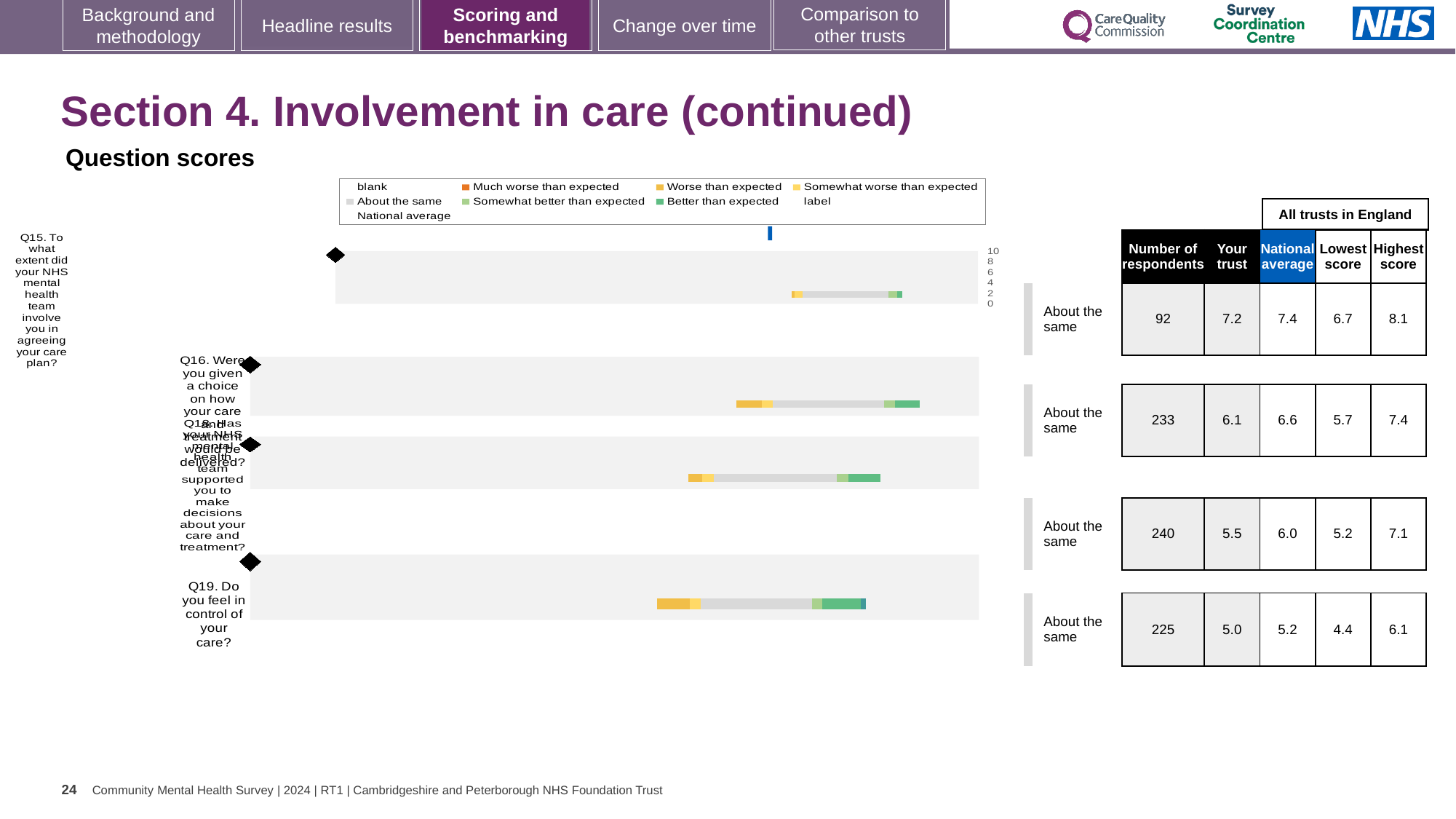
What is the 'Your trust' score for Q16 in the table? 6.1 For Q16, which is larger: the 'Your trust' score or the national average? National average According to the table, how many respondents answered Q15? 92 Which question has the highest 'Your trust' score in the table? Q15 What is the national average score for Q18 in the table? 6.0 For Q15, what is the difference between the national average and the 'Your trust' score? 0.2 How many survey questions (categories) are plotted in the chart? 4 What benchmark category label is shown next to each of the four questions? About the same Which question has the lowest 'Your trust' score in the table? Q19 What is the highest score across all trusts in England for Q19? 6.1 What is the lowest score across all trusts in England for Q18? 5.2 What kind of chart is shown under 'Question scores'? bar chart